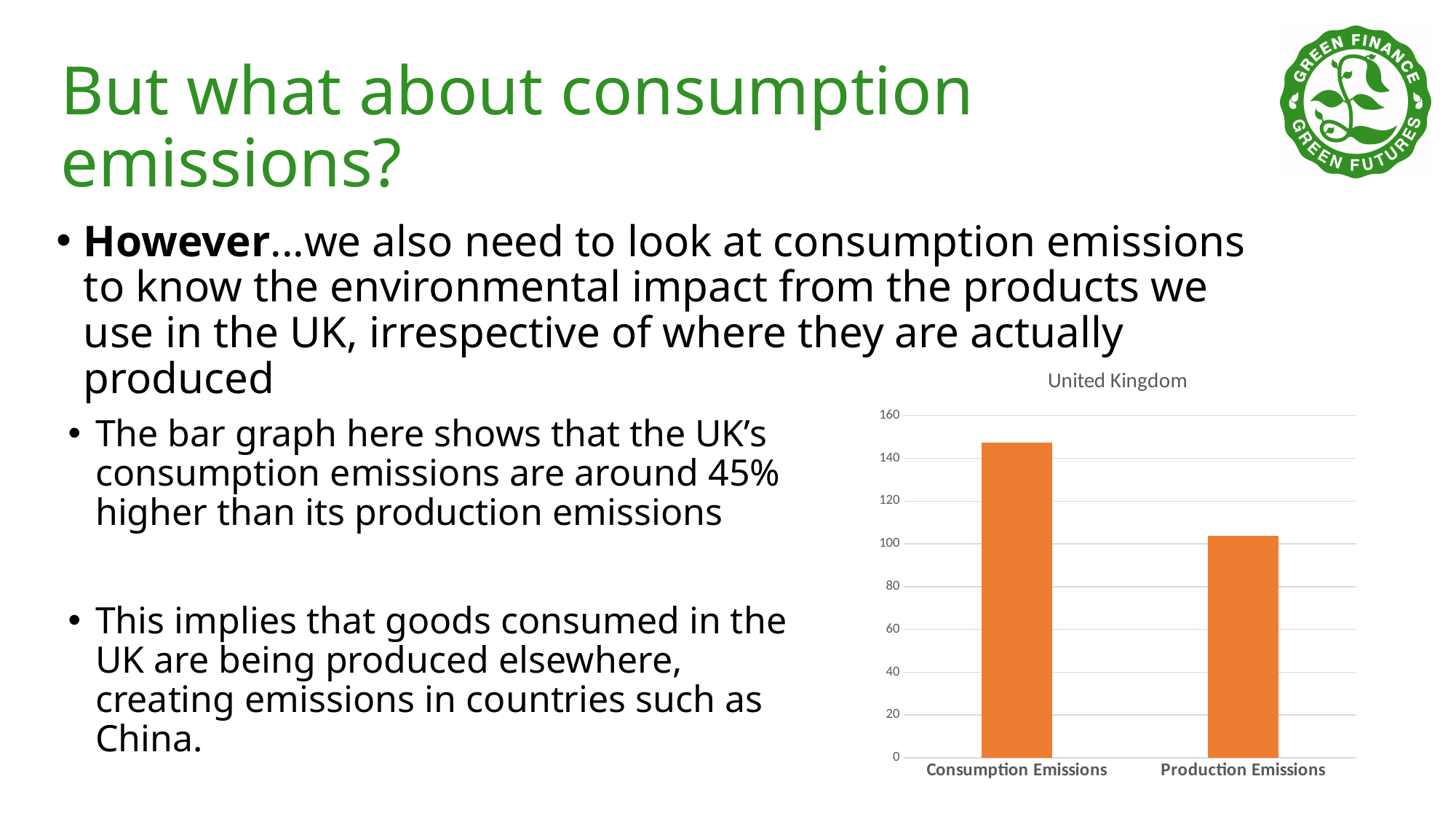
Which category has the highest value in the chart? Consumption Emissions Which is larger, Consumption Emissions or Production Emissions? Consumption Emissions Is the value for Production Emissions greater or less than 100? greater What kind of chart is shown on the slide? bar chart Which category has the lowest value in the chart? Production Emissions What is the highest value shown on the vertical axis of the chart? 160 Do the values rise or fall from left to right across the categories? fall What is the title of the chart? United Kingdom Is the value for Consumption Emissions greater or less than 160? less How many categories are plotted in the chart? 2 Is the value for Consumption Emissions greater or less than 140? greater